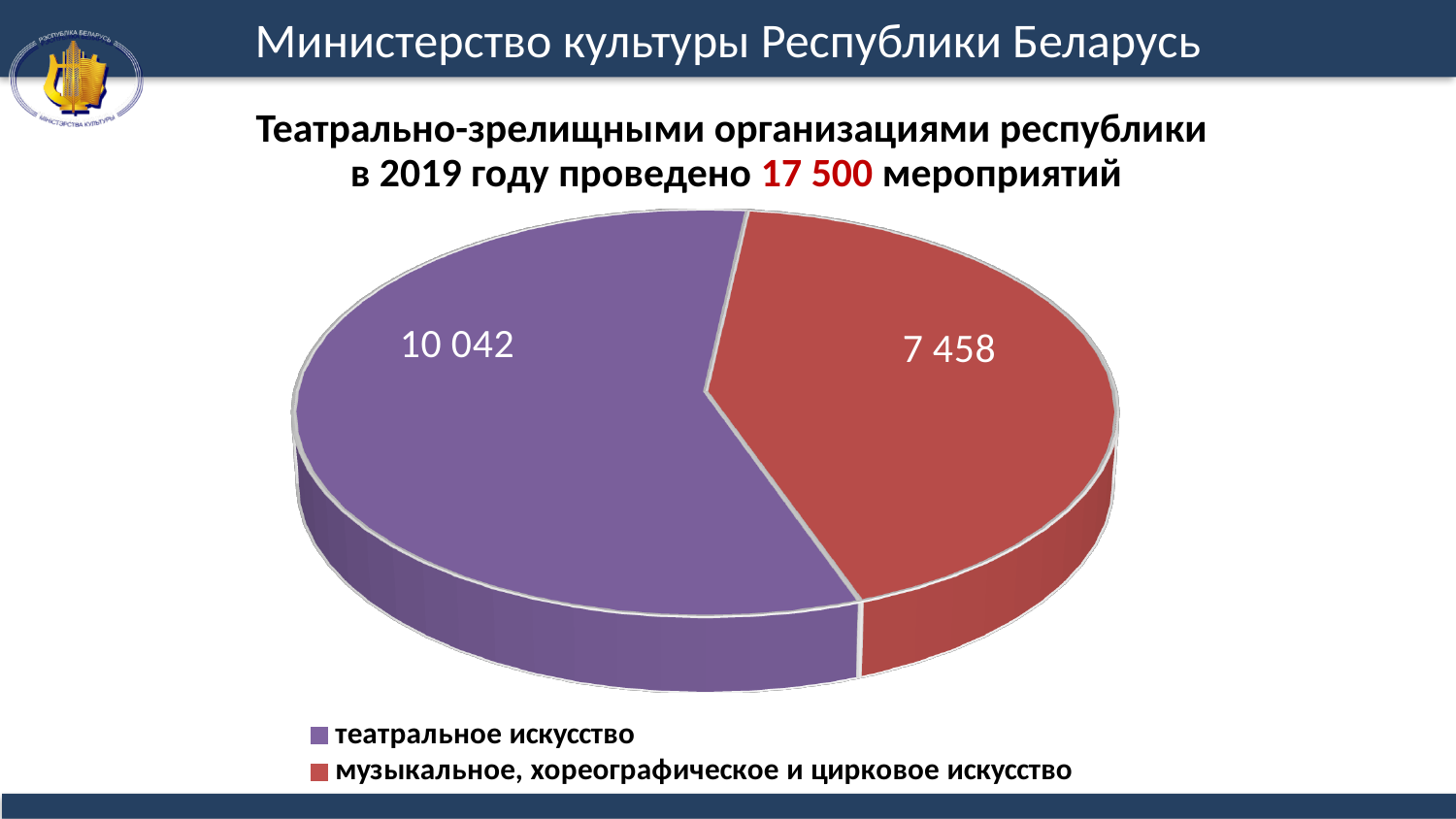
Which category has the smallest slice? музыкальное, хореографическое и цирковое искусство How many entries does the legend list? 2 What share of the pie does театральное искусство represent, to the nearest whole percent? 57% What is the total of the two slices in the pie chart? 17 500 How many slices does the pie chart have? 2 What kind of chart is shown on the slide? Pie chart Which category has the largest slice? театральное искусство Which is larger: театральное искусство or музыкальное, хореографическое и цирковое искусство? театральное искусство What is the value for театральное искусство? 10 042 What is the value for музыкальное, хореографическое и цирковое искусство? 7 458 What colour is the slice for музыкальное, хореографическое и цирковое искусство? Red What is the difference between the value for театральное искусство and the value for музыкальное, хореографическое и цирковое искусство? 2 584